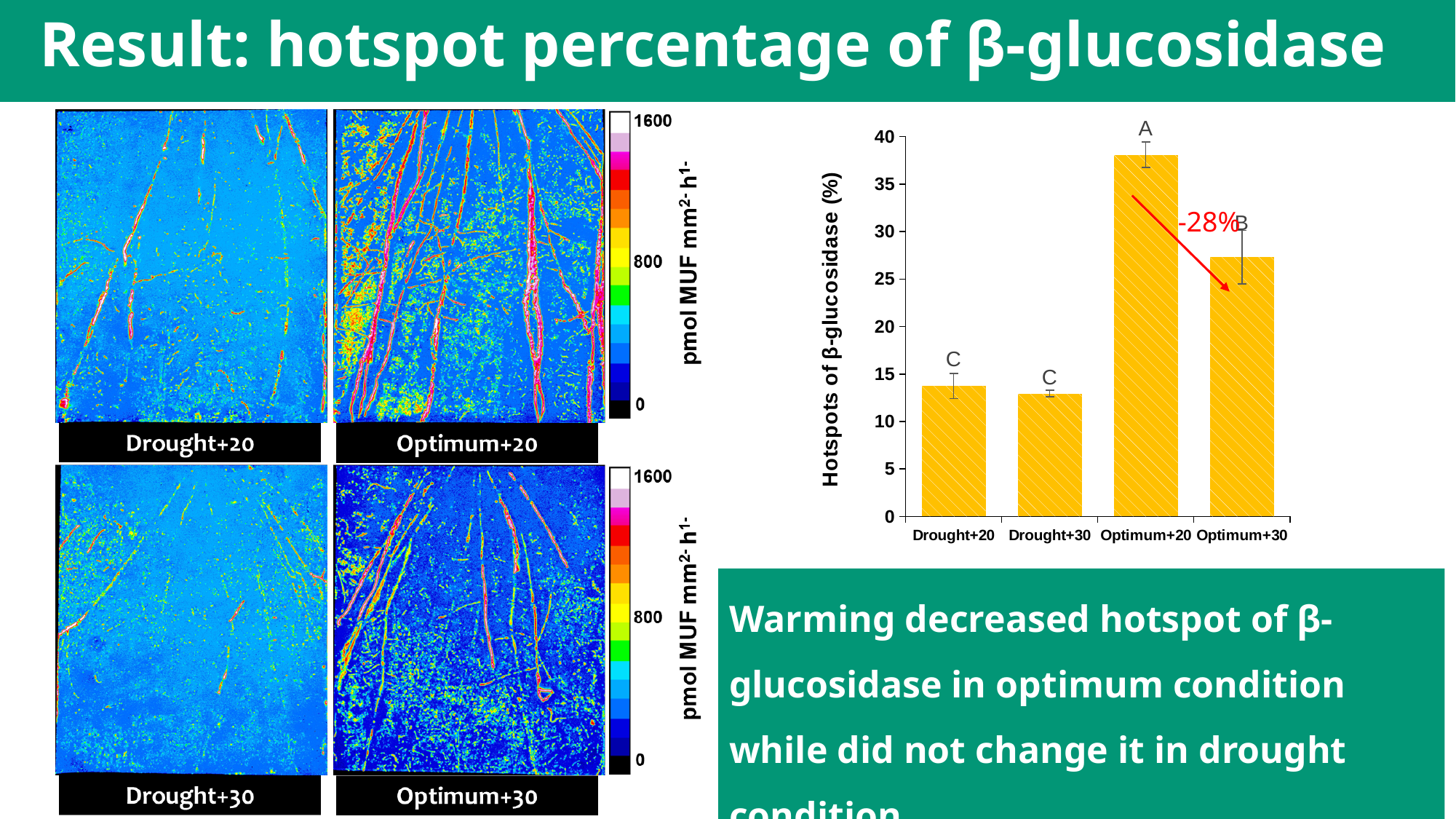
What kind of chart is shown on the right side of the slide? bar chart What percentage change is annotated in red between the Optimum+20 and Optimum+30 bars? -28% Which is larger, the value for Drought+20 or the value for Optimum+30? Optimum+30 Is the value for Optimum+20 greater or less than 35? greater Is the value for Optimum+30 greater or less than 30? less Which category has the highest hotspot percentage of β-glucosidase? Optimum+20 What is the label of the y axis on the bar chart? Hotspots of β-glucosidase (%) How many categories are plotted on the bar chart? 4 Is the value for Drought+20 greater or less than 15? less Which is larger, the value for Optimum+20 or the value for Optimum+30? Optimum+20